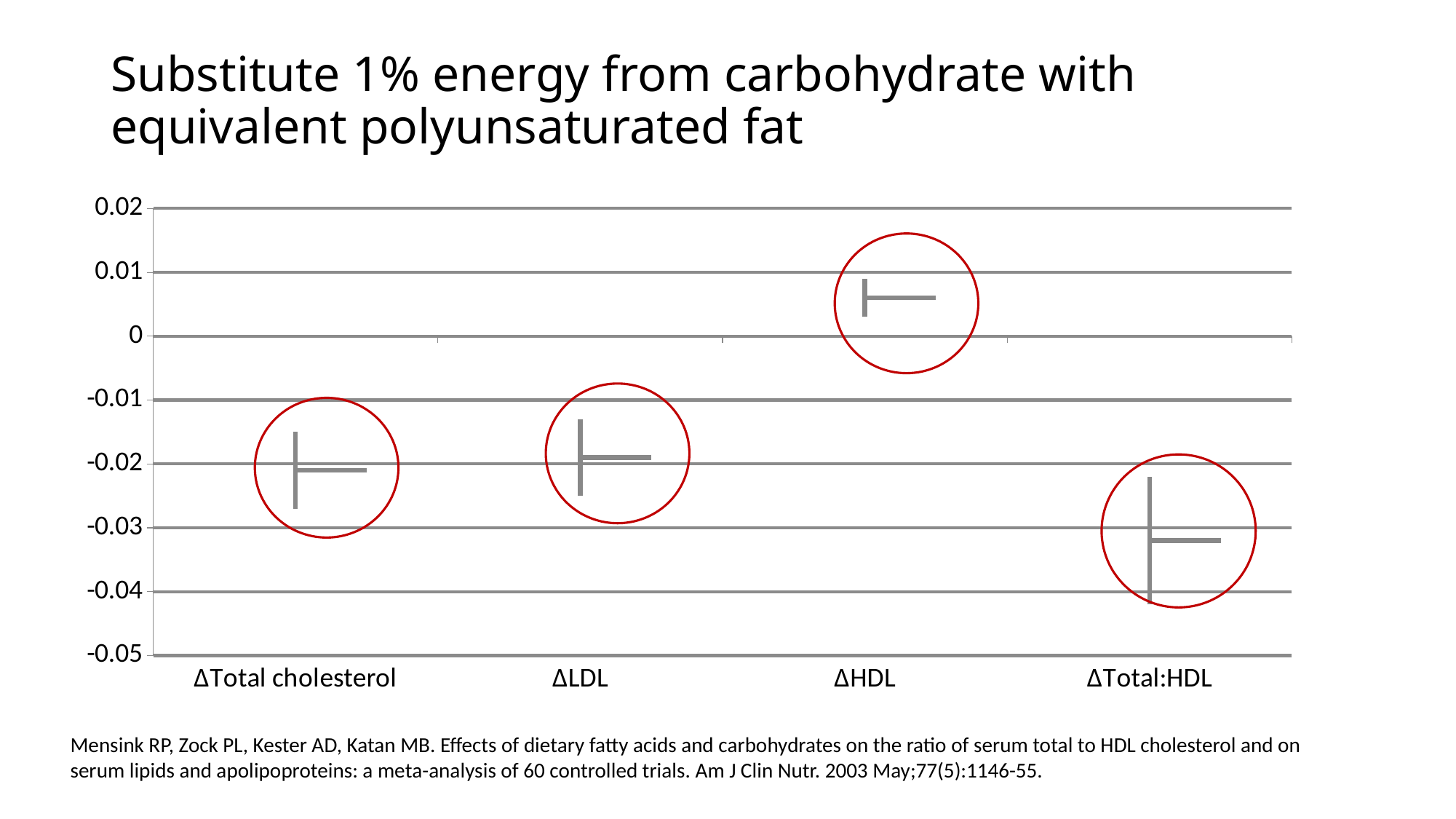
How many categories are shown on the x axis of the chart? 4 What is the title of the slide containing the chart? Substitute 1% energy from carbohydrate with equivalent polyunsaturated fat Which category has the lowest value in the chart? ΔTotal:HDL Is the value for ΔTotal cholesterol greater or less than -0.01? less Which category has the highest value in the chart? ΔHDL Is the value for ΔLDL greater or less than -0.03? greater Which is larger, the value for ΔLDL or the value for ΔTotal:HDL? ΔLDL Is the value for ΔTotal:HDL greater or less than -0.03? less What is the highest value shown on the y axis of the chart? 0.02 Which is larger, the value for ΔHDL or the value for ΔTotal:HDL? ΔHDL